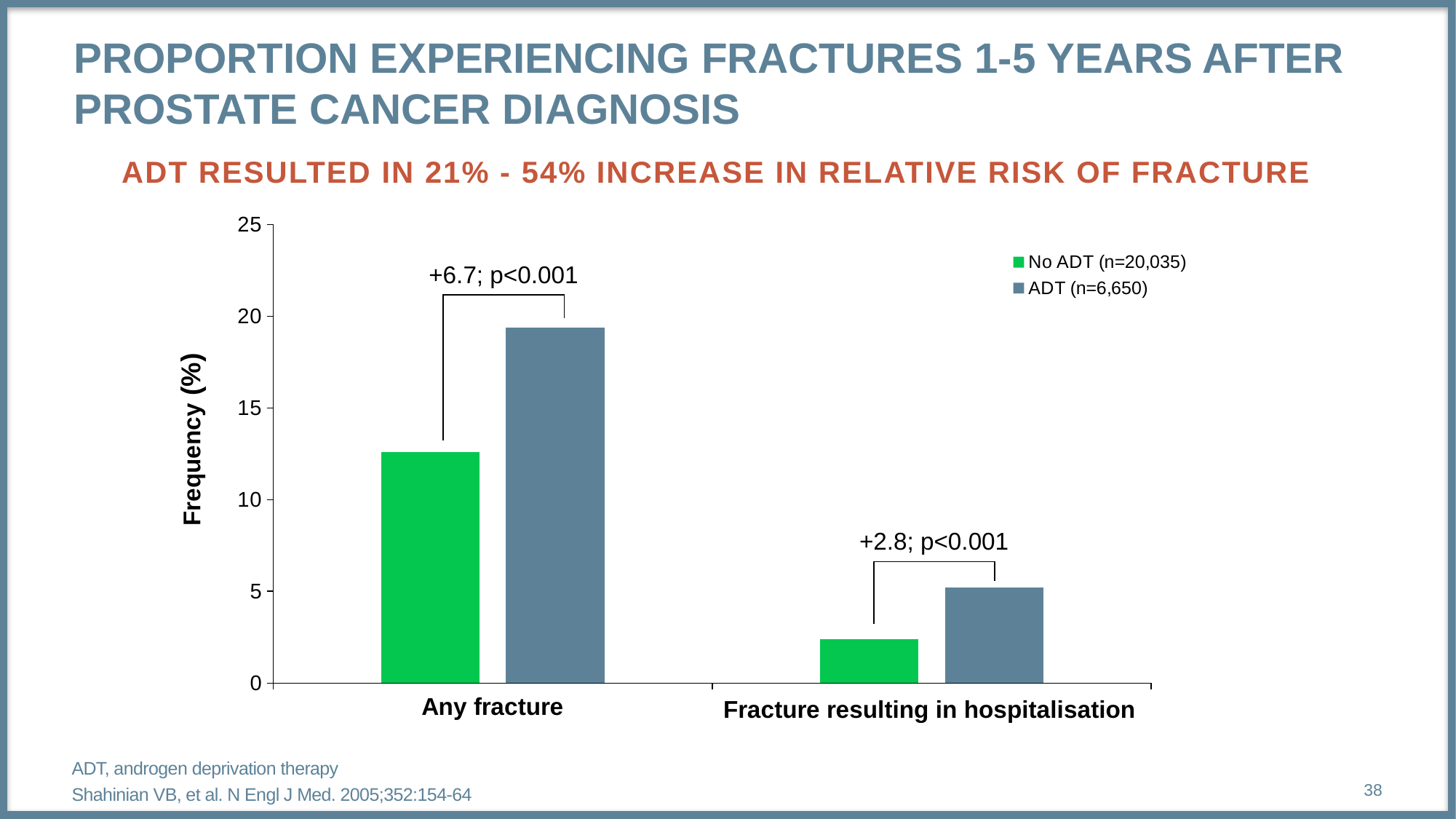
What is the label of the y axis? Frequency (%) Is the value for ADT in the Any fracture category greater or less than 15? greater Which series has the lower frequency for Fracture resulting in hospitalisation? No ADT (n=20,035) Is the value for No ADT in the Any fracture category greater or less than 15? less Which series has the higher frequency for Any fracture? ADT (n=6,650) Is the value for No ADT in the Fracture resulting in hospitalisation category greater or less than 5? less Which category has the highest bar overall? Any fracture What kind of chart is shown on the slide? Bar chart According to the annotation, by how much does the ADT frequency exceed the No ADT frequency for Fracture resulting in hospitalisation? +2.8 How many categories are shown on the x axis? 2 According to the annotation, by how much does the ADT frequency exceed the No ADT frequency for Any fracture? +6.7 How many series does the legend list? 2